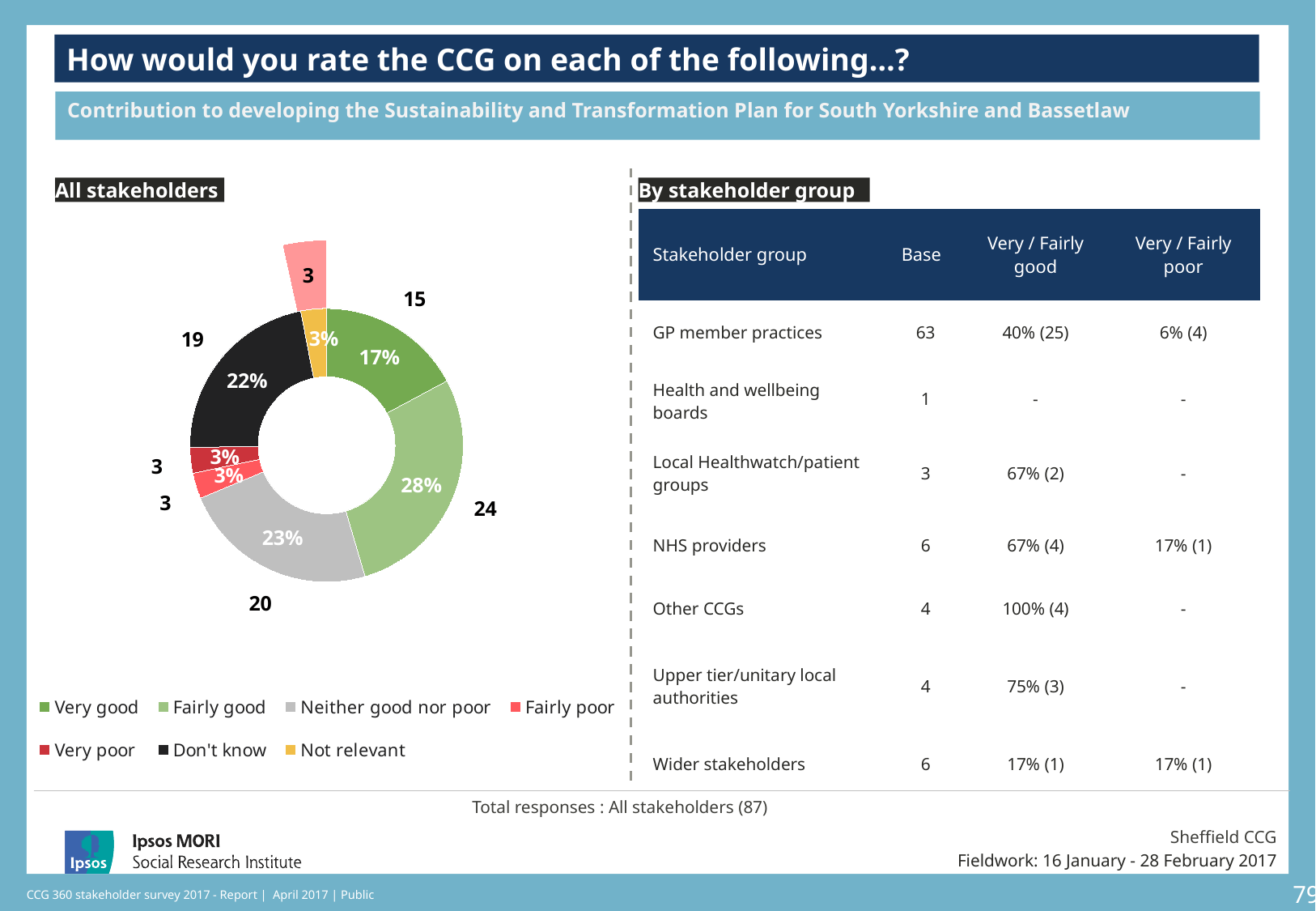
How many response categories does the legend of the donut chart list? 7 How many respondents answered 'Don't know' according to the count label on the donut chart? 19 What is the difference in percentage points between 'Fairly good' and 'Very good' in the donut chart? 11 percentage points What percentage of all stakeholders rated the CCG 'Very good'? 17% What percentage of all stakeholders rated the CCG 'Fairly good' on its contribution to developing the Sustainability and Transformation Plan? 28% Which is larger in the donut chart: the share for 'Neither good nor poor' or the share for 'Don't know'? Neither good nor poor How many respondents rated the CCG 'Fairly good' according to the count label on the donut chart? 24 What colour represents 'Don't know' in the donut chart? Black What percentage of all stakeholders answered 'Don't know' in the donut chart? 22% What percentage of all stakeholders rated the CCG 'Neither good nor poor'? 23% Which response category has the largest share of the donut chart? Fairly good What type of chart is used to show the ratings for all stakeholders? Pie (donut) chart